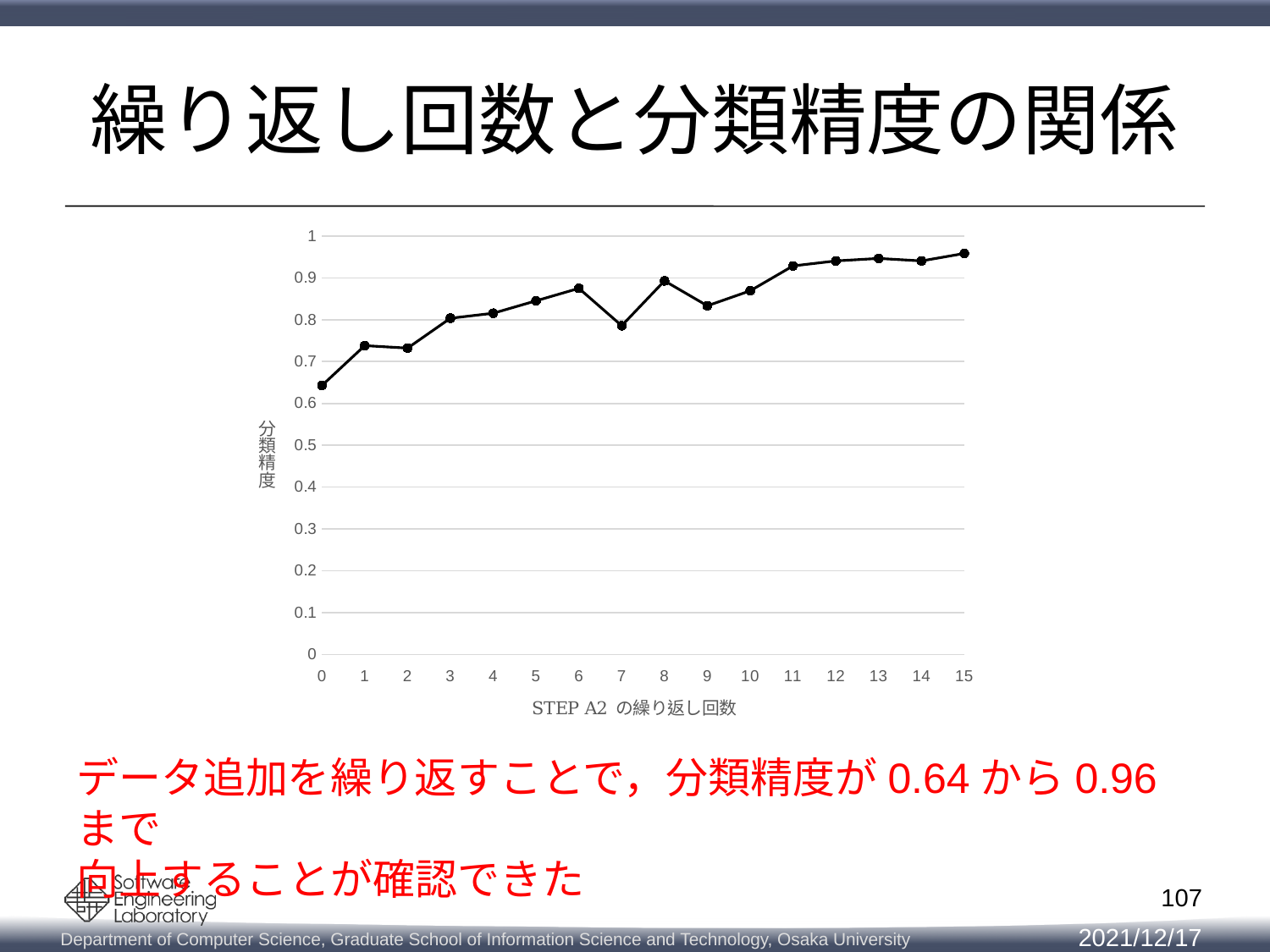
What is the label of the x axis? STEP A2 の繰り返し回数 At which iteration count is the classification accuracy lowest? 0 Which has the higher classification accuracy, iteration 7 or iteration 8? iteration 8 How many data points are plotted on the chart? 16 What kind of chart is shown on the slide? line chart Is the classification accuracy at iteration 6 greater or less than 0.8? greater At which iteration count is the classification accuracy highest? 15 Is the classification accuracy at iteration 11 greater or less than 0.9? greater What is the label of the y axis? 分類精度 Which has the higher classification accuracy, iteration 9 or iteration 10? iteration 10 Is the classification accuracy at iteration 0 greater or less than 0.7? less Overall, does the classification accuracy rise or fall as the iteration count increases? rise